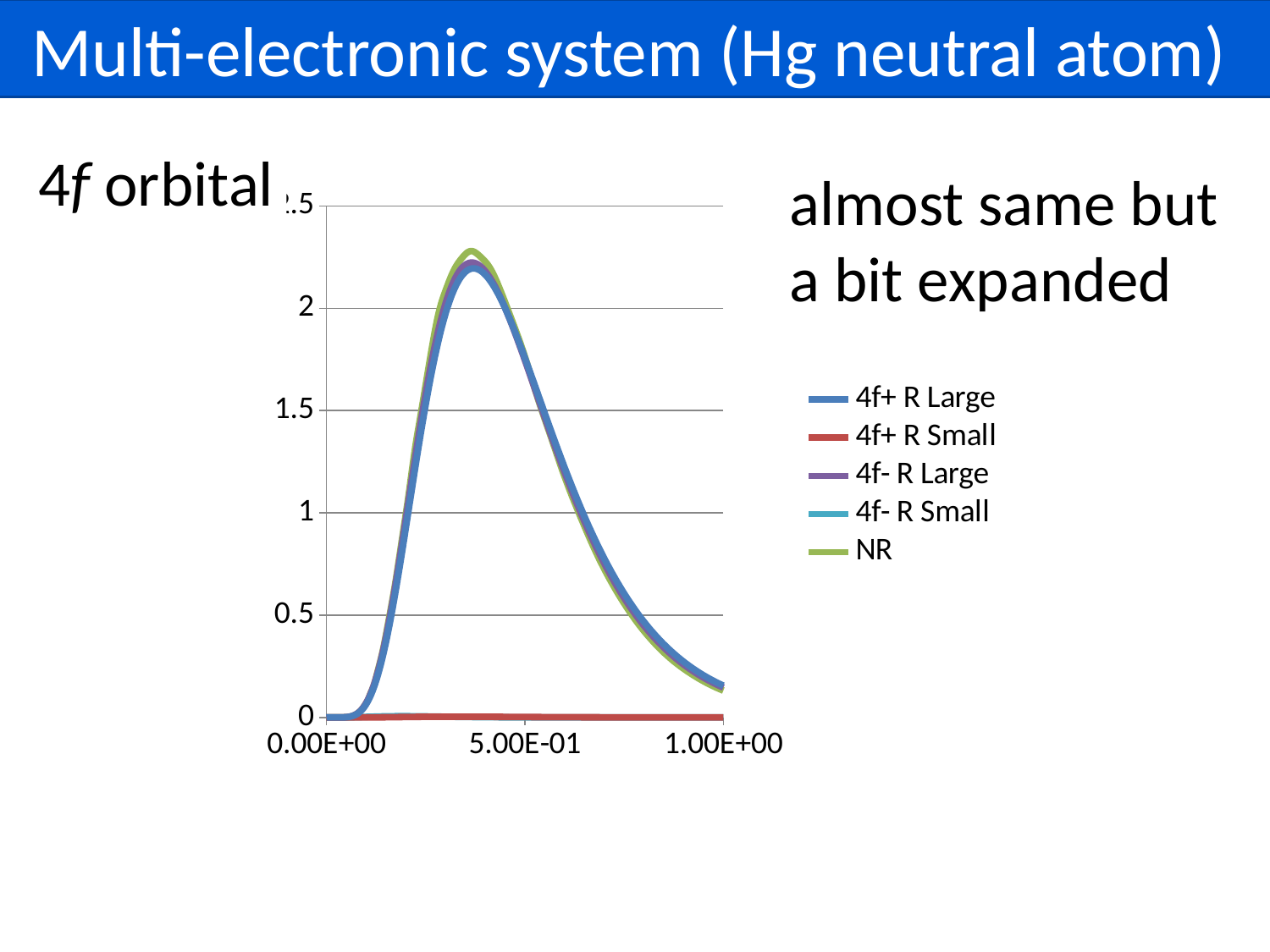
What colour is the NR line in the chart? green How many series does the legend list? 5 What kind of chart is shown on the slide? line chart What is the largest x-axis tick label shown on the chart? 1.00E+00 Which series is listed last in the legend? NR Is the peak value of the NR series greater or less than 2? greater Is the peak value of the 4f+ R Large series greater or less than 1.5? greater Is the value of the 4f+ R Small series at 5.00E-01 greater or less than 0.5? less At 5.00E-01 on the x axis, which is larger: the 4f+ R Large series or the 4f+ R Small series? 4f+ R Large Do the values of the NR series rise or fall between 5.00E-01 and 1.00E+00 on the x axis? fall